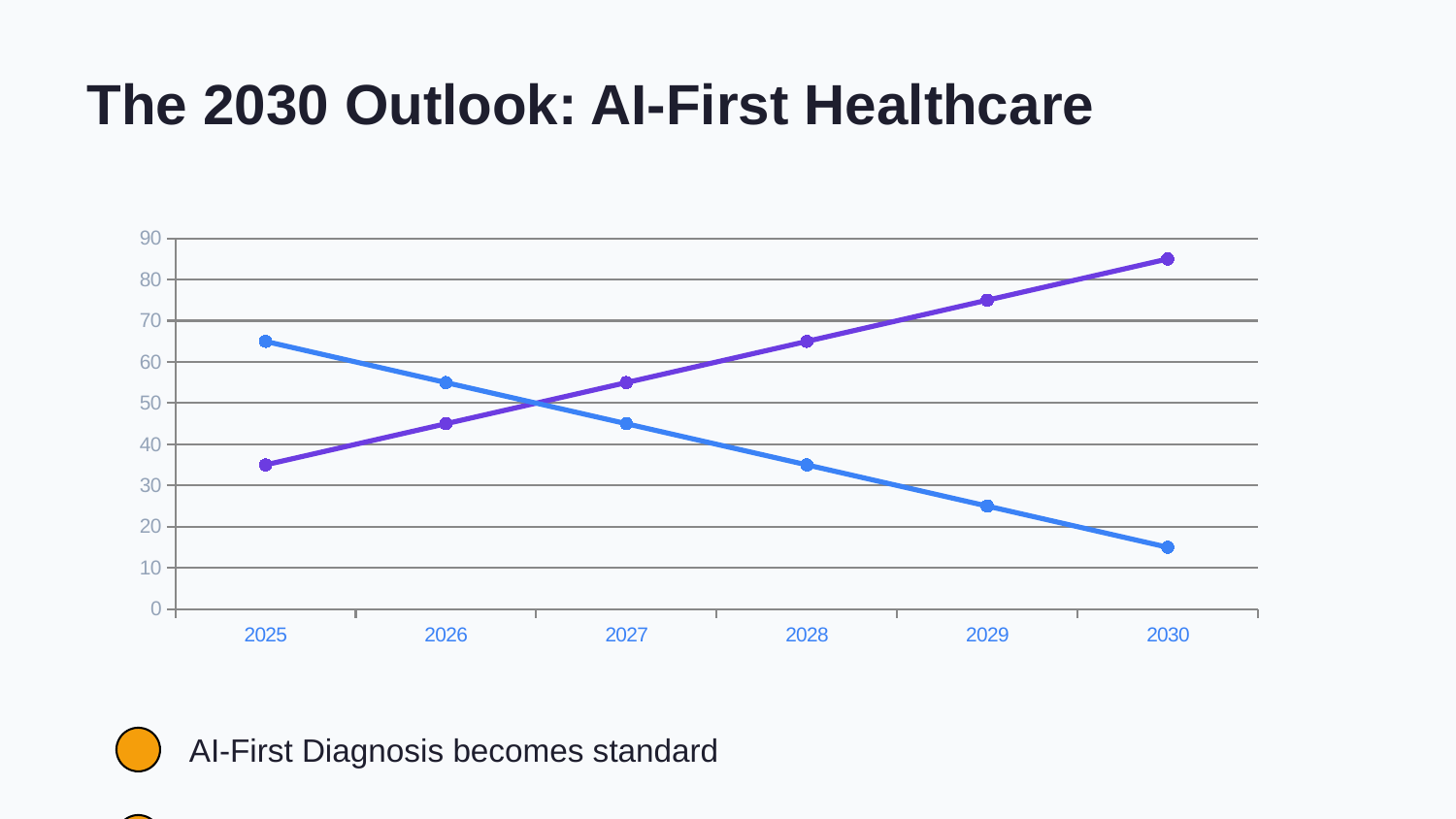
In 2025, which line has the higher value, the purple line or the blue line? blue line Does the blue line rise or fall from 2025 to 2030? fall Is the value of the blue line in 2025 greater or less than 60? greater What kind of chart is shown on the slide? line chart Does the purple line rise or fall from 2025 to 2030? rise Is the value of the purple line in 2030 greater or less than 80? greater How many lines are plotted on the chart? 2 In 2028, which line has the higher value, the purple line or the blue line? purple line How many years are shown along the x axis of the chart? 6 Is the value of the purple line in 2025 greater or less than 40? less In which year does the purple line reach its highest value? 2030